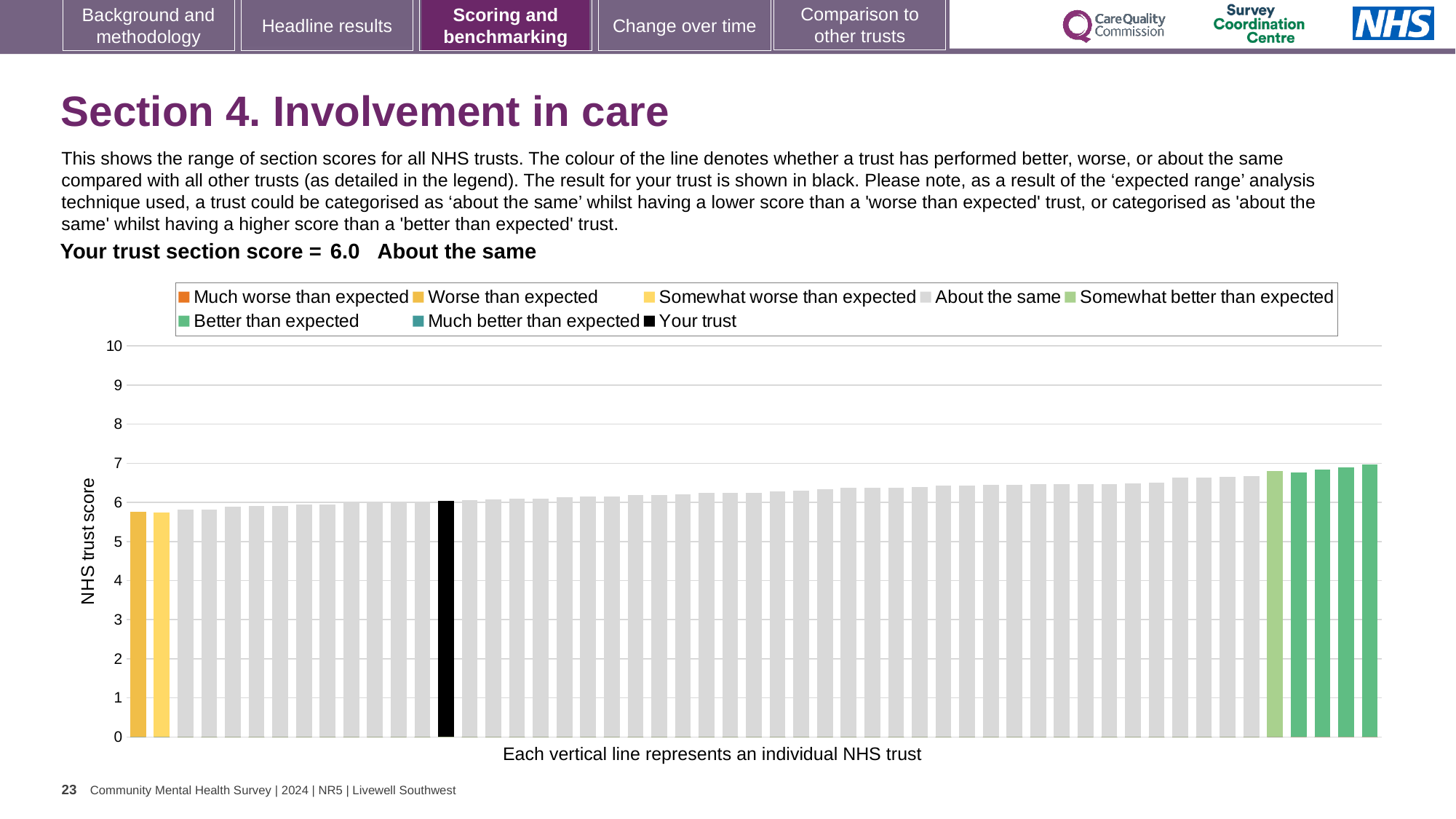
What colour is the bar representing your trust? black How many entries does the chart legend list? 8 Which category is your trust placed in for this section? About the same Do the bar values rise or fall from left to right along the x axis? rise Which bar is larger, the leftmost bar or the rightmost bar? the rightmost bar Is the value of the black bar (your trust) greater or less than 5? greater What kind of chart is shown on the slide? bar chart What is the section score for your trust shown on the slide? 6.0 How many bars are coloured as 'Better than expected' (dark green)? 4 Is the value of the lowest bar greater or less than 6? less Is the value of the highest bar greater or less than 6? greater What is the label on the vertical axis of the chart? NHS trust score